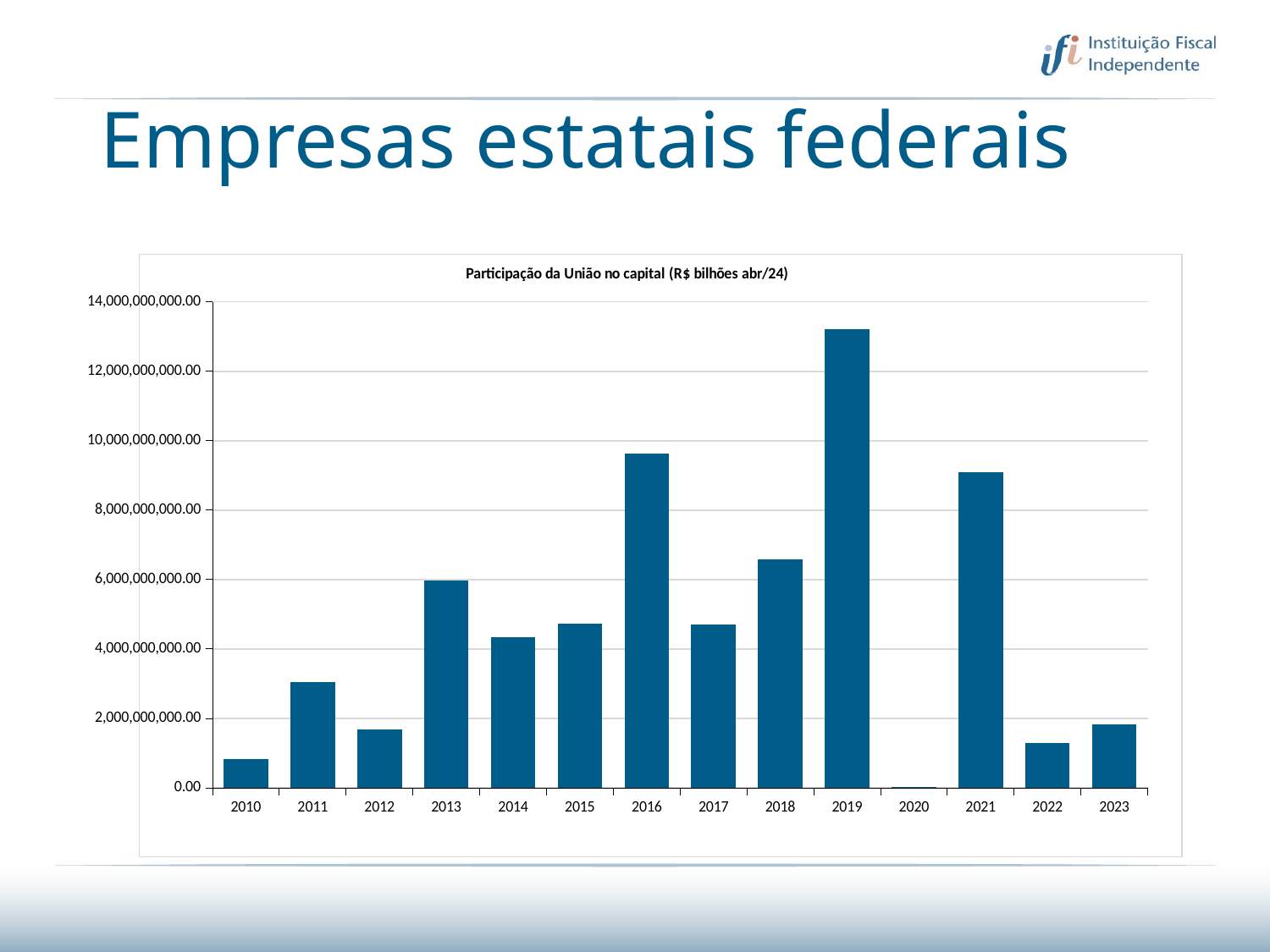
How many years are shown on the x axis of the chart? 14 Do the values rise or fall from 2019 to 2020? fall Is the value for 2016 greater or less than 10,000,000,000.00? less Is the value for 2019 greater or less than 12,000,000,000.00? greater Which year has the highest value in the chart? 2019 Which year has the larger value, 2013 or 2018? 2018 Is the value for 2022 greater or less than 2,000,000,000.00? less Which year has the lowest value in the chart? 2020 What kind of chart is shown on the slide? bar chart What is the title of the chart? Participação da União no capital (R$ bilhões abr/24) Which year has the larger value, 2016 or 2021? 2016